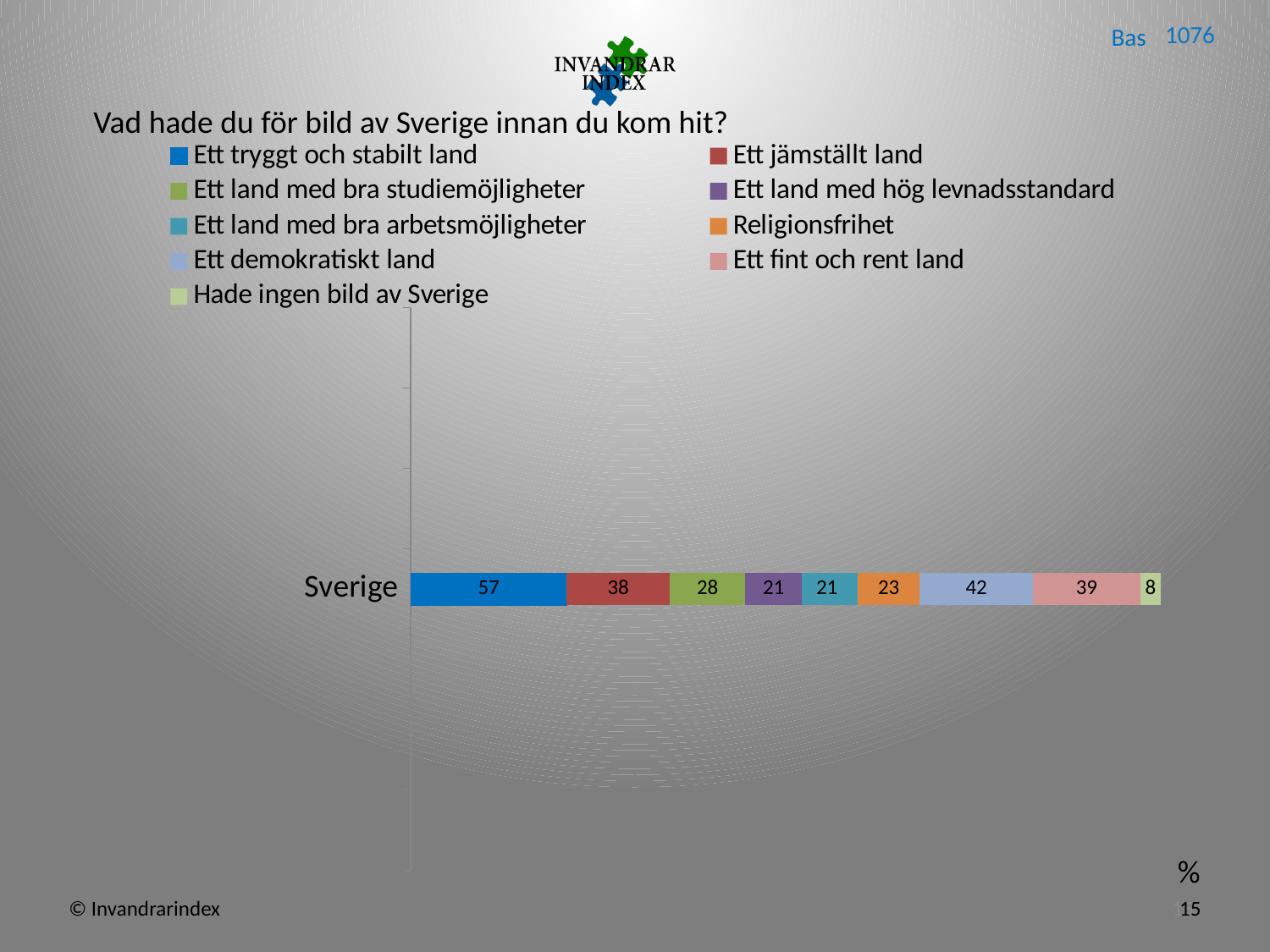
What is the value for "Religionsfrihet" in the Sverige bar? 23 Which series has the highest value in the Sverige bar? Ett tryggt och stabilt land Which series has the lowest value in the Sverige bar? Hade ingen bild av Sverige How many categories are shown on the vertical axis? 1 How many series does the legend list? 9 What is the total of all segments in the Sverige bar? 277 What is the value for "Hade ingen bild av Sverige" in the Sverige bar? 8 What is the difference between the values for "Ett tryggt och stabilt land" and "Ett jämställt land"? 19 What is the value for "Ett tryggt och stabilt land" in the Sverige bar? 57 What is the value for "Ett demokratiskt land" in the Sverige bar? 42 What kind of chart is shown on the slide? Stacked bar chart Which is larger: the value for "Ett demokratiskt land" or the value for "Ett fint och rent land"? Ett demokratiskt land